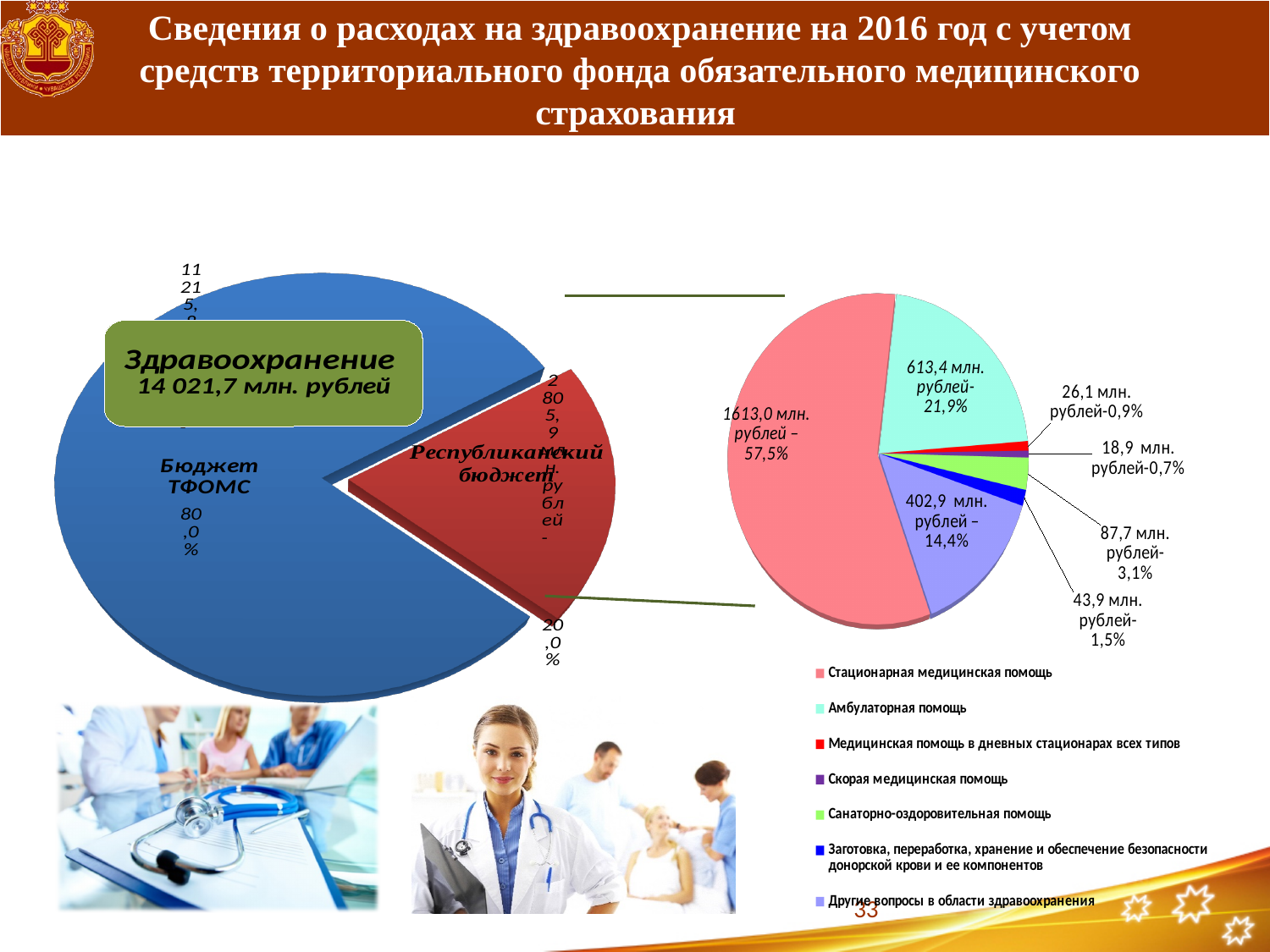
On the right pie chart, what is the difference in share between Санаторно-оздоровительная помощь (3,1%) and Заготовка, переработка, хранение и обеспечение безопасности донорской крови и ее компонентов (1,5%)? 1,6% On the right pie chart, what share does Амбулаторная помощь have? 21,9% On the right pie chart, which category has the largest share? Стационарная медицинская помощь What type of chart is shown on the right side of the slide? Pie chart On the left pie chart, what share of the total does Бюджет ТФОМС account for? 80,0% On the right pie chart, which category has the smallest share? Скорая медицинская помощь On the left pie chart, what total amount for Здравоохранение is shown in the green box? 14 021,7 млн. рублей On the right pie chart, how many categories does the legend list? 7 On the left pie chart, what share of the total does Республиканский бюджет account for? 20,0% On the right pie chart, what is the value for Другие вопросы в области здравоохранения? 402,9 млн. рублей On the right pie chart, what value and share are shown for Стационарная медицинская помощь? 1613,0 млн. рублей – 57,5% On the left pie chart, which of the two slices is larger, Бюджет ТФОМС or Республиканский бюджет? Бюджет ТФОМС